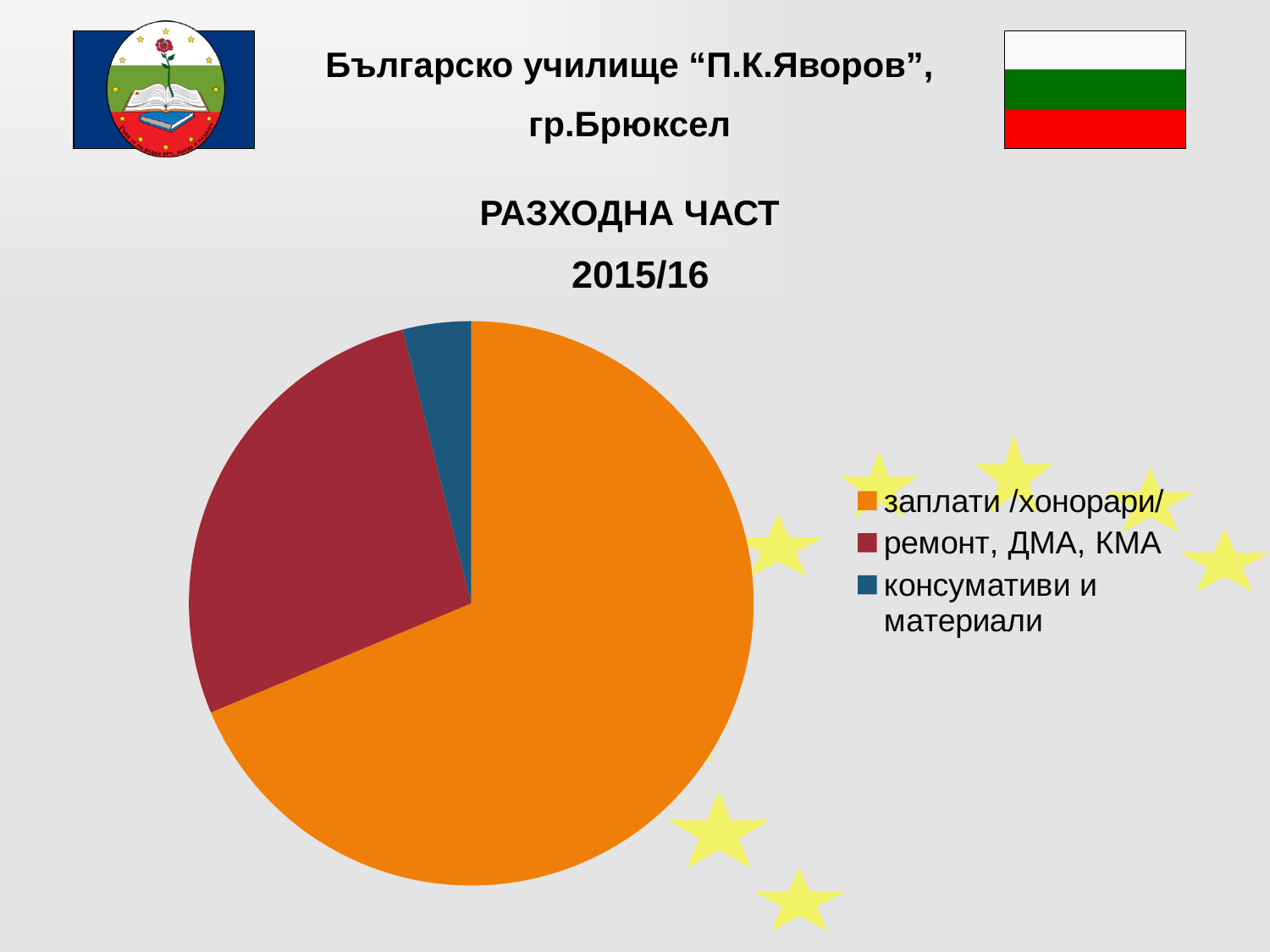
What kind of chart is shown on the slide? pie chart Which category takes the smallest share of the pie chart? консумативи и материали Which slice is larger: ремонт, ДМА, КМА or консумативи и материали? ремонт, ДМА, КМА How many entries does the legend of the pie chart list? 3 Which slice is larger: заплати /хонорари/ or ремонт, ДМА, КМА? заплати /хонорари/ Which category takes the largest share of the pie chart? заплати /хонорари/ What is the title of the pie chart? 2015/16 What colour is the slice for консумативи и материали? blue How many slices does the pie chart have? 3